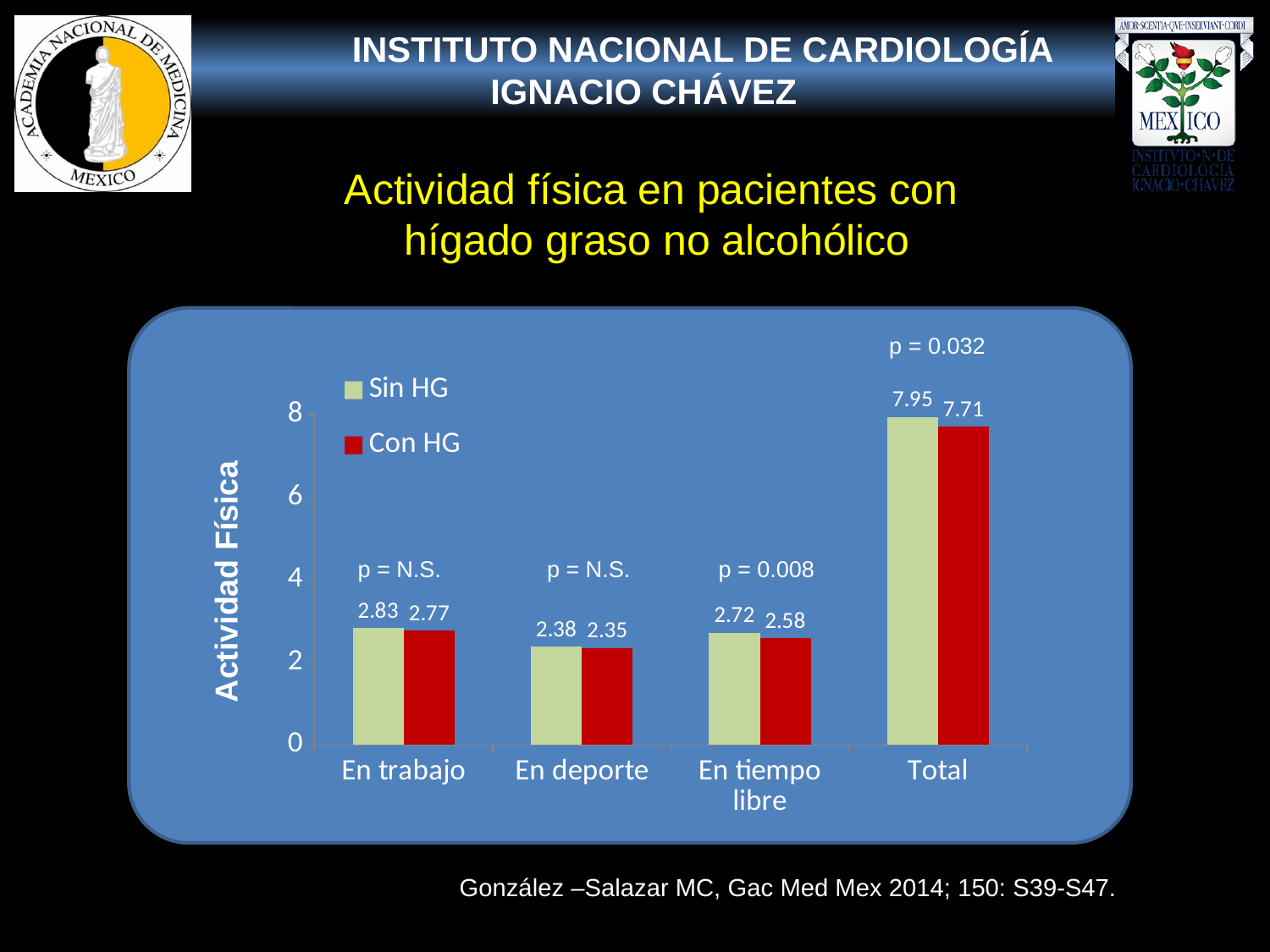
What is the difference between Sin HG and Con HG in the En tiempo libre category? 0.14 What is the value for Sin HG in the En trabajo category? 2.83 Which category has the highest value for Sin HG? Total How many categories are shown on the x axis? 4 What kind of chart is shown on the slide? bar chart Is the Sin HG value for En deporte greater or less than 4? less Which category has the lowest value for Con HG? En deporte What is the value for Con HG in the En tiempo libre category? 2.58 What is the label of the y axis? Actividad Física What is the difference between Sin HG and Con HG in the Total category? 0.24 How many series does the legend list? 2 What is the value for Con HG in the Total category? 7.71